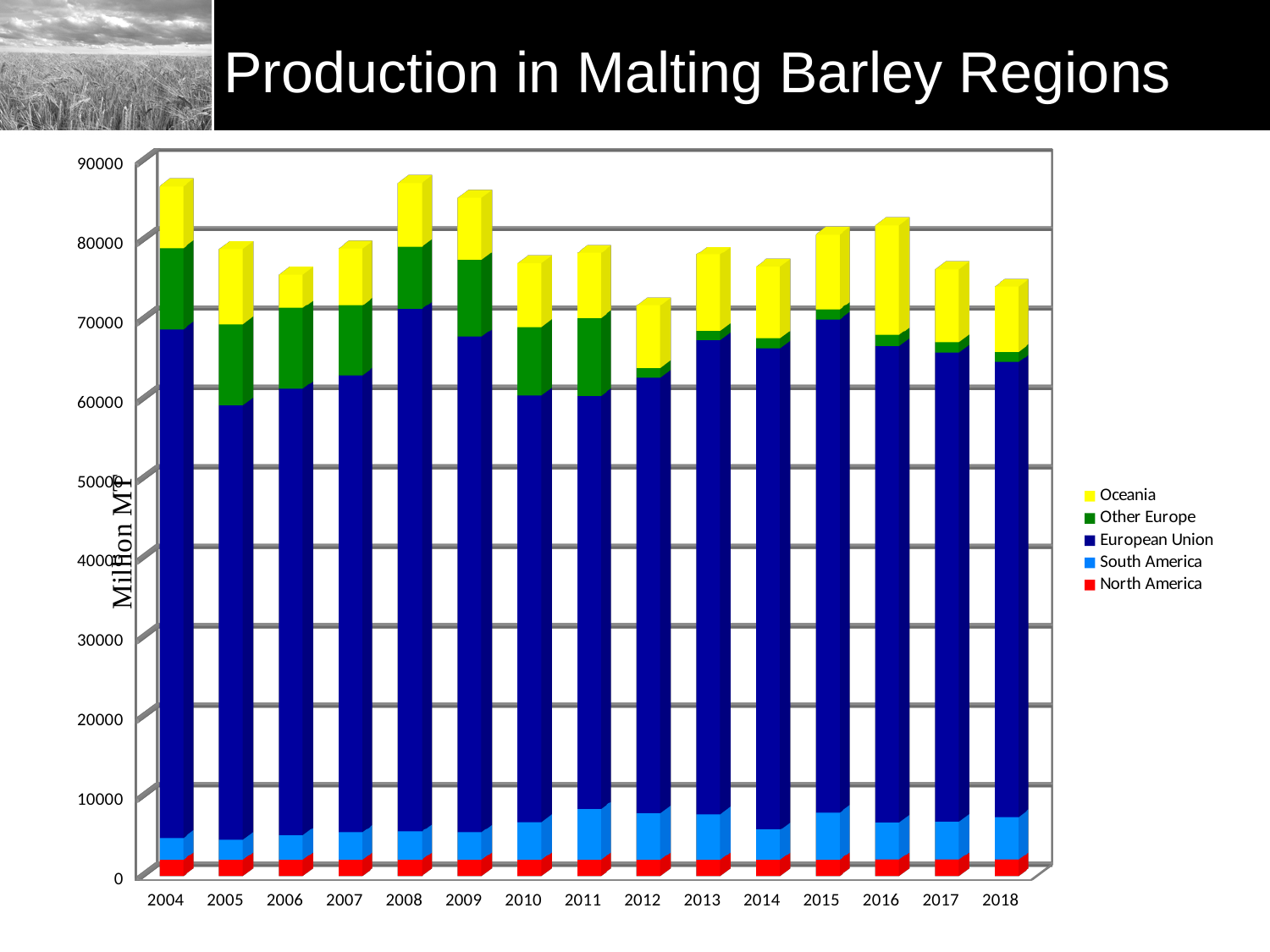
Is the total production for 2012 greater or less than 80000? less What is the title of the chart on the slide? Production in Malting Barley Regions Which series is shown in yellow in the chart? Oceania What kind of chart is shown on the slide? stacked bar chart Is the total production for 2016 greater or less than 80000? greater Is the total production for 2006 greater or less than 80000? less Which year has the larger total production, 2016 or 2017? 2016 How many series does the chart's legend list? 5 Which year has the lowest total production in the chart? 2012 How many years are shown along the x axis of the chart? 15 Which year has the larger total production, 2009 or 2010? 2009